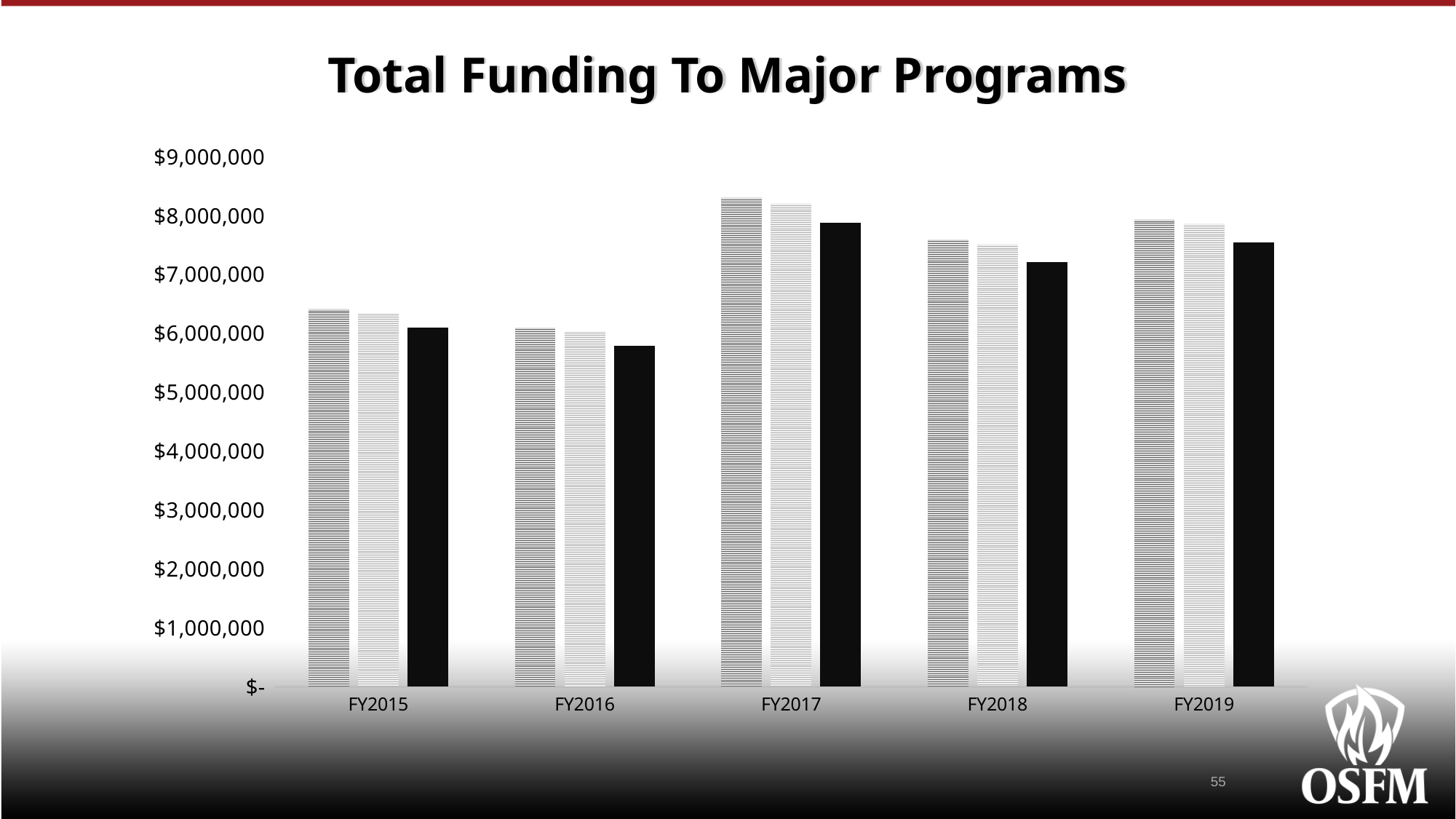
How many bars are plotted for each fiscal year? 3 Is the value of the solid black bar for FY2019 greater or less than $8,000,000? less Is the value of the first (leftmost) bar for FY2015 greater or less than $6,000,000? greater What type of chart is shown on the slide? bar chart Which fiscal year has the lowest bars? FY2016 Which has the larger solid black bar, FY2017 or FY2018? FY2017 Is the value of the solid black bar for FY2016 greater or less than $6,000,000? less Which fiscal year has the highest bars? FY2017 What is the title of the chart? Total Funding To Major Programs How many fiscal years are shown on the x axis? 5